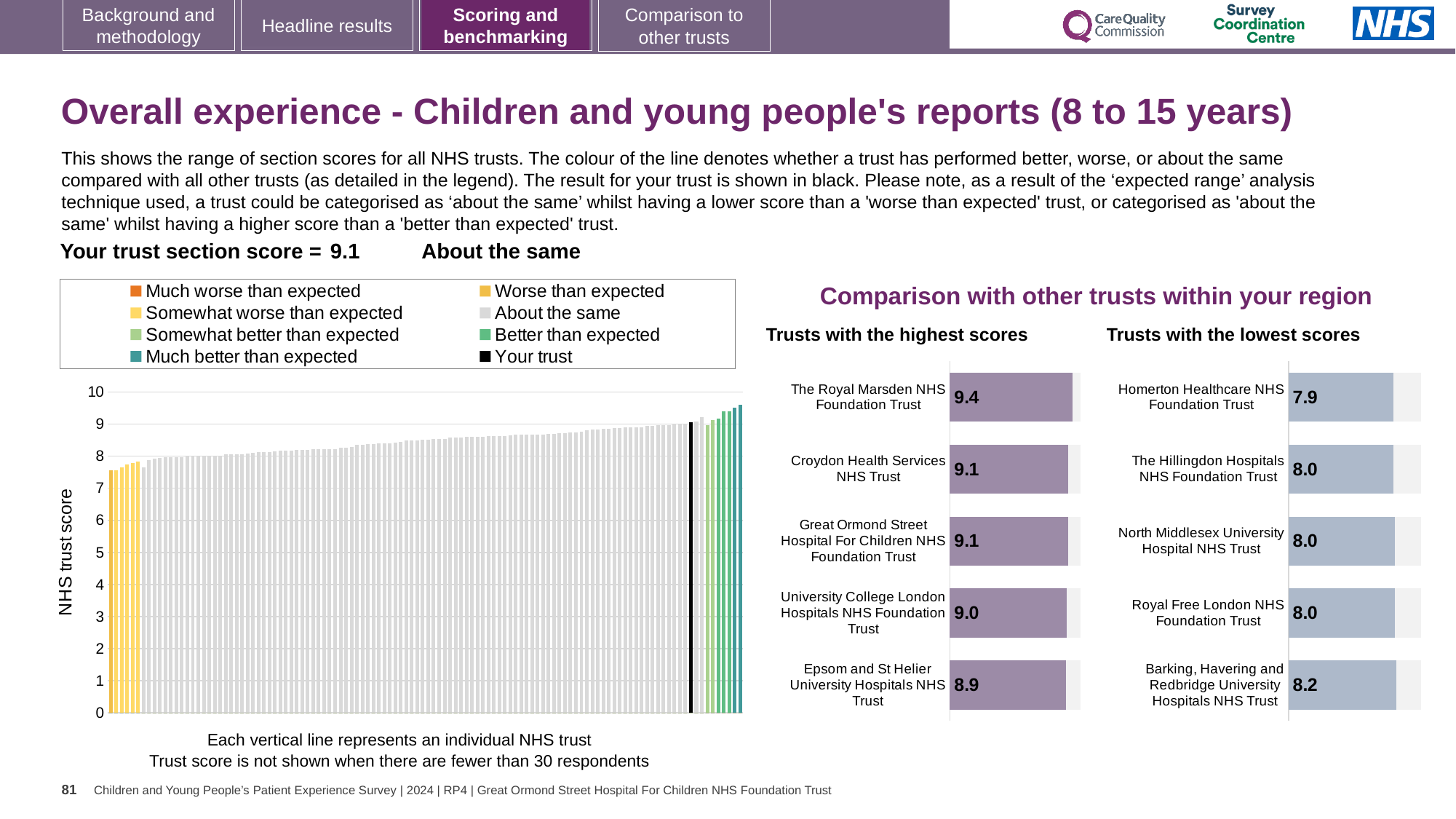
In the 'Trusts with the highest scores' chart, what is the difference between the scores of The Royal Marsden NHS Foundation Trust and Epsom and St Helier University Hospitals NHS Trust? 0.5 How many trusts are listed in the 'Trusts with the highest scores' chart? 5 How many entries does the legend of the large chart on the left list? 8 What kind of chart is the large chart on the left with the 'NHS trust score' axis? bar chart In the 'Trusts with the lowest scores' chart, which has the higher score: Barking, Havering and Redbridge University Hospitals NHS Trust or The Hillingdon Hospitals NHS Foundation Trust? Barking, Havering and Redbridge University Hospitals NHS Trust What is the label on the vertical axis of the large chart on the left? NHS trust score In the 'Trusts with the highest scores' chart, which trust has the highest score? The Royal Marsden NHS Foundation Trust In the 'Trusts with the lowest scores' chart, which trust has the lowest score? Homerton Healthcare NHS Foundation Trust In the 'Trusts with the lowest scores' chart, what is the score for Homerton Healthcare NHS Foundation Trust? 7.9 In the large chart on the left, do the trust scores rise or fall from left to right? rise According to the slide, what is your trust's section score? 9.1 In the 'Trusts with the highest scores' chart, what is the score for The Royal Marsden NHS Foundation Trust? 9.4